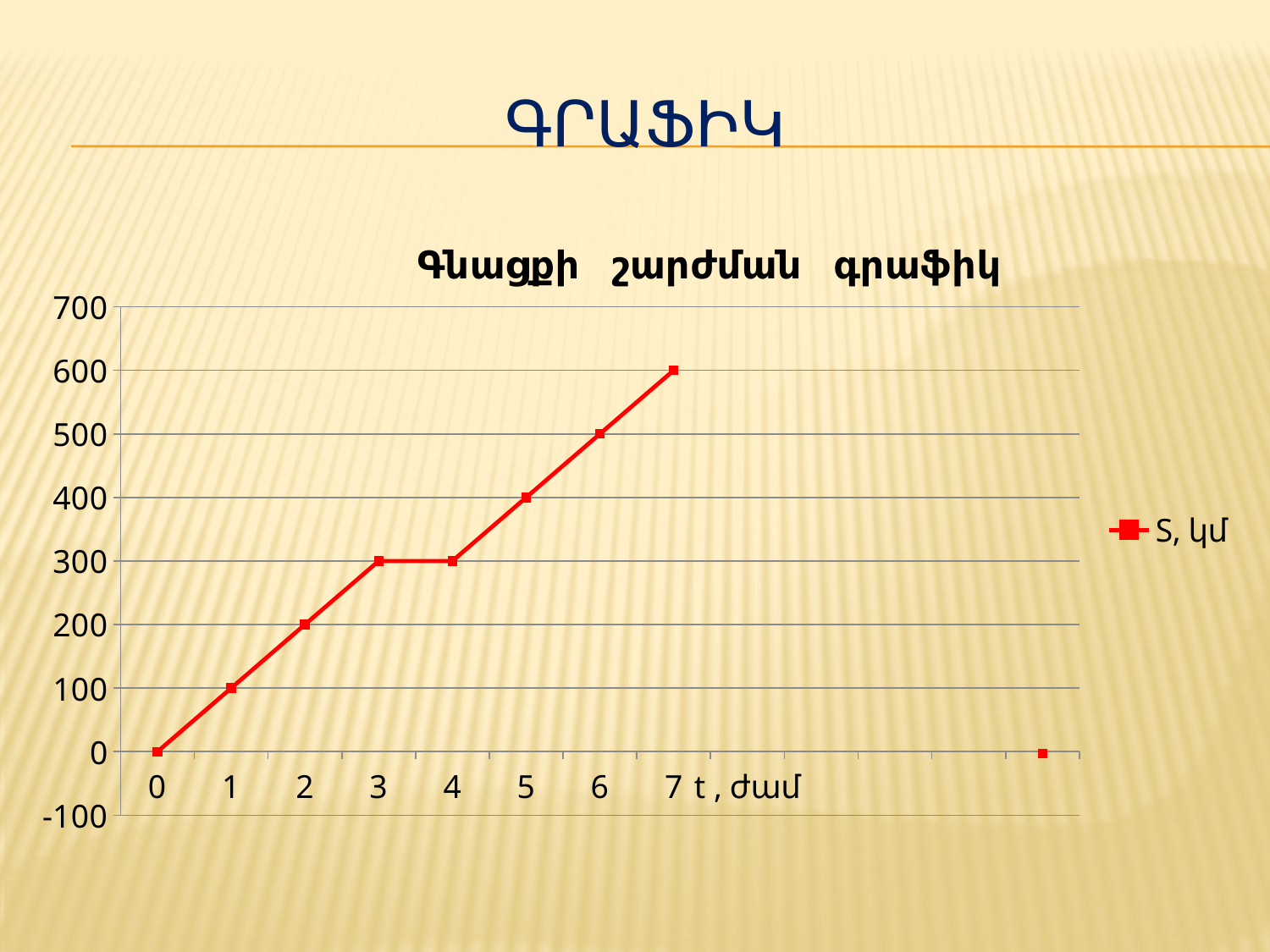
How many series does the legend list? 1 What is the legend entry for the plotted series? S, կմ What is the value of S, կմ at t = 4? 300 What is the value of S, կմ at t = 3? 300 Do the values of S, կմ generally rise or fall as t increases from 0 to 7? rise What is the difference between the value of S, կմ at t = 7 and at t = 3? 300 What is the value of S, կմ at t = 7? 600 What kind of chart is shown on the slide? line chart At which value of t is S, կմ highest? 7 At which value of t is S, կմ lowest? 0 What is the value of S, կմ at t = 1? 100 Which is larger, the value of S, կմ at t = 5 or at t = 2? t = 5